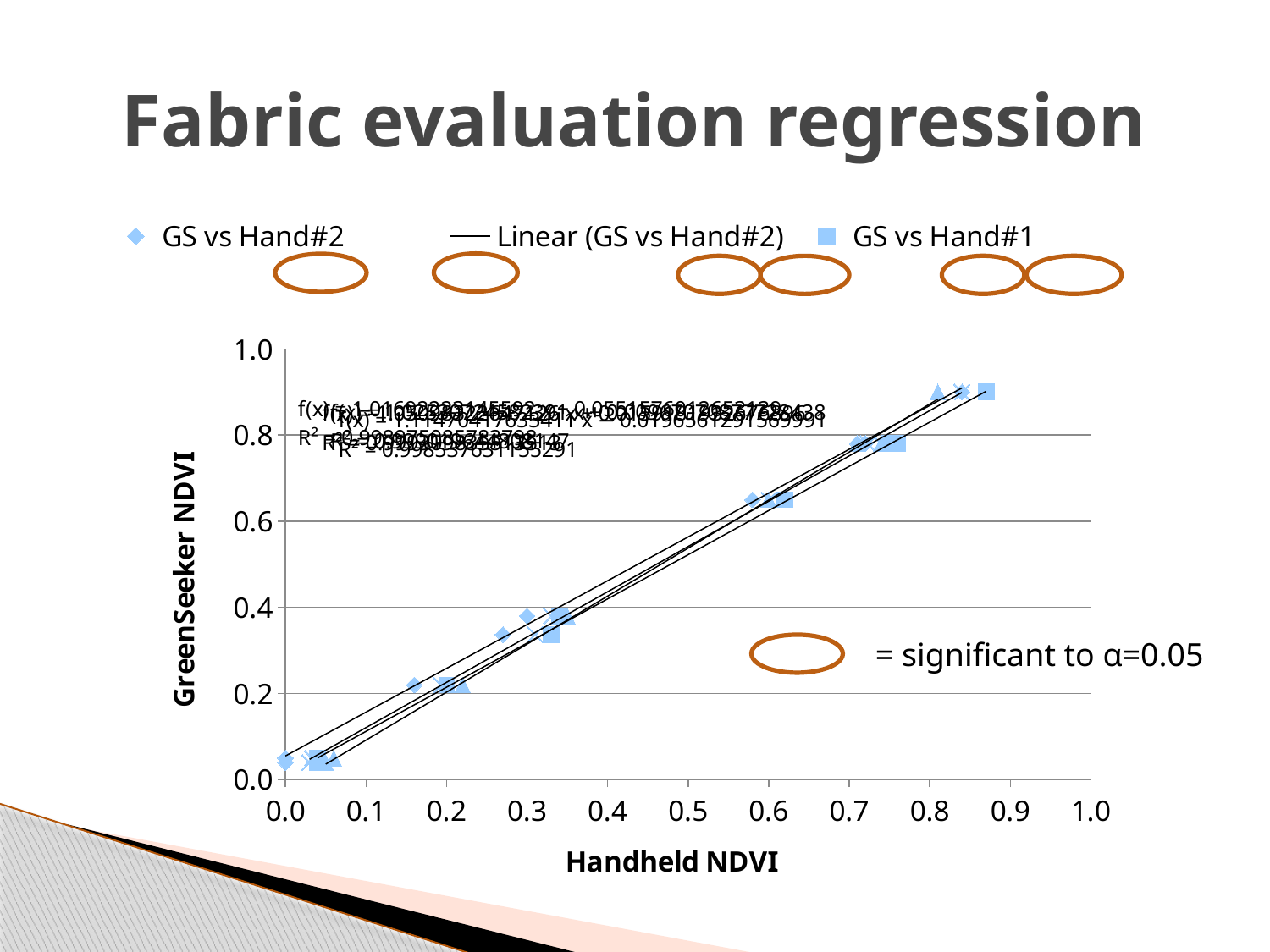
How many tick labels are shown on the horizontal axis? 11 What kind of chart is shown on the slide? scatter chart What is the title of the slide containing the chart? Fabric evaluation regression What is the label of the vertical axis of the chart? GreenSeeker NDVI Is the highest GreenSeeker NDVI value plotted greater or less than 0.8? greater Is the lowest GreenSeeker NDVI value plotted greater or less than 0.2? less Do the GreenSeeker NDVI values rise or fall as Handheld NDVI increases along the x axis? rise What is the label of the horizontal axis of the chart? Handheld NDVI How many entries does the chart legend list? 3